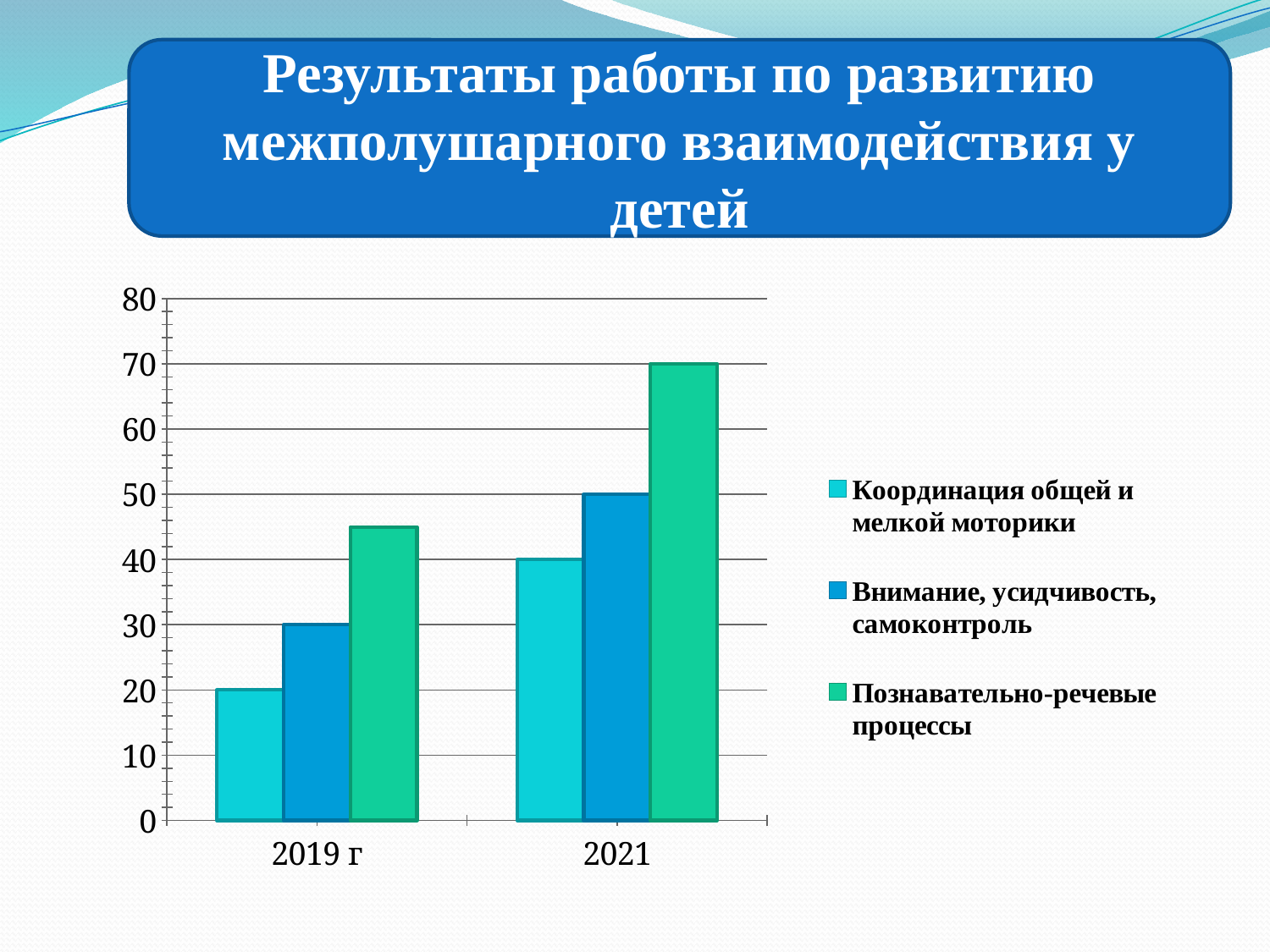
What is the difference between the values for Познавательно-речевые процессы and Координация общей и мелкой моторики in 2021? 30 How many series does the legend list? 3 What is the value for Внимание, усидчивость, самоконтроль in 2019 г? 30 What is the value for Координация общей и мелкой моторики in 2021? 40 What is the value for Познавательно-речевые процессы in 2021? 70 Is the value for Познавательно-речевые процессы in 2019 г greater or less than 40? greater Which series has the lowest value in 2019 г? Координация общей и мелкой моторики Do the values for Внимание, усидчивость, самоконтроль rise or fall from 2019 г to 2021? rise Which series has the highest value in 2021? Познавательно-речевые процессы What is the value for Координация общей и мелкой моторики in 2019 г? 20 What is the value for Внимание, усидчивость, самоконтроль in 2021? 50 How many categories are shown on the x axis? 2